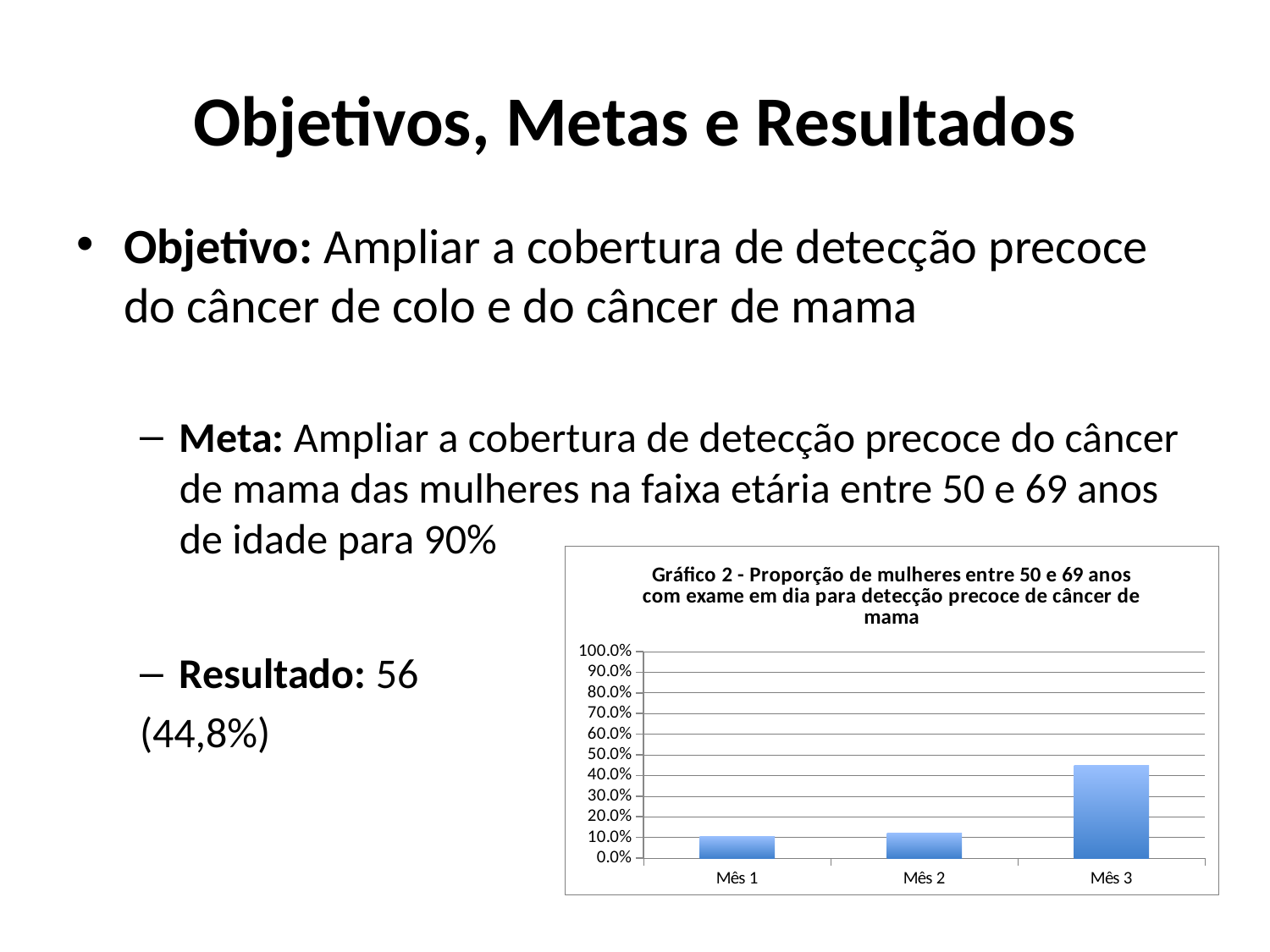
Which month has the highest value in the chart? Mês 3 Do the values rise or fall from Mês 1 to Mês 3? rise How many months (categories) are plotted in the chart? 3 Which is larger, the value for Mês 3 or the value for Mês 2? Mês 3 Is the value for Mês 3 greater or less than 40.0%? greater Is the value for Mês 1 greater or less than 20.0%? less Is the value for Mês 3 greater or less than 50.0%? less What is the highest value shown on the chart's vertical axis? 100.0% What kind of chart is shown on the slide? bar chart Which is larger, the value for Mês 3 or the value for Mês 1? Mês 3 What is the title of the chart? Gráfico 2 - Proporção de mulheres entre 50 e 69 anos com exame em dia para detecção precoce de câncer de mama